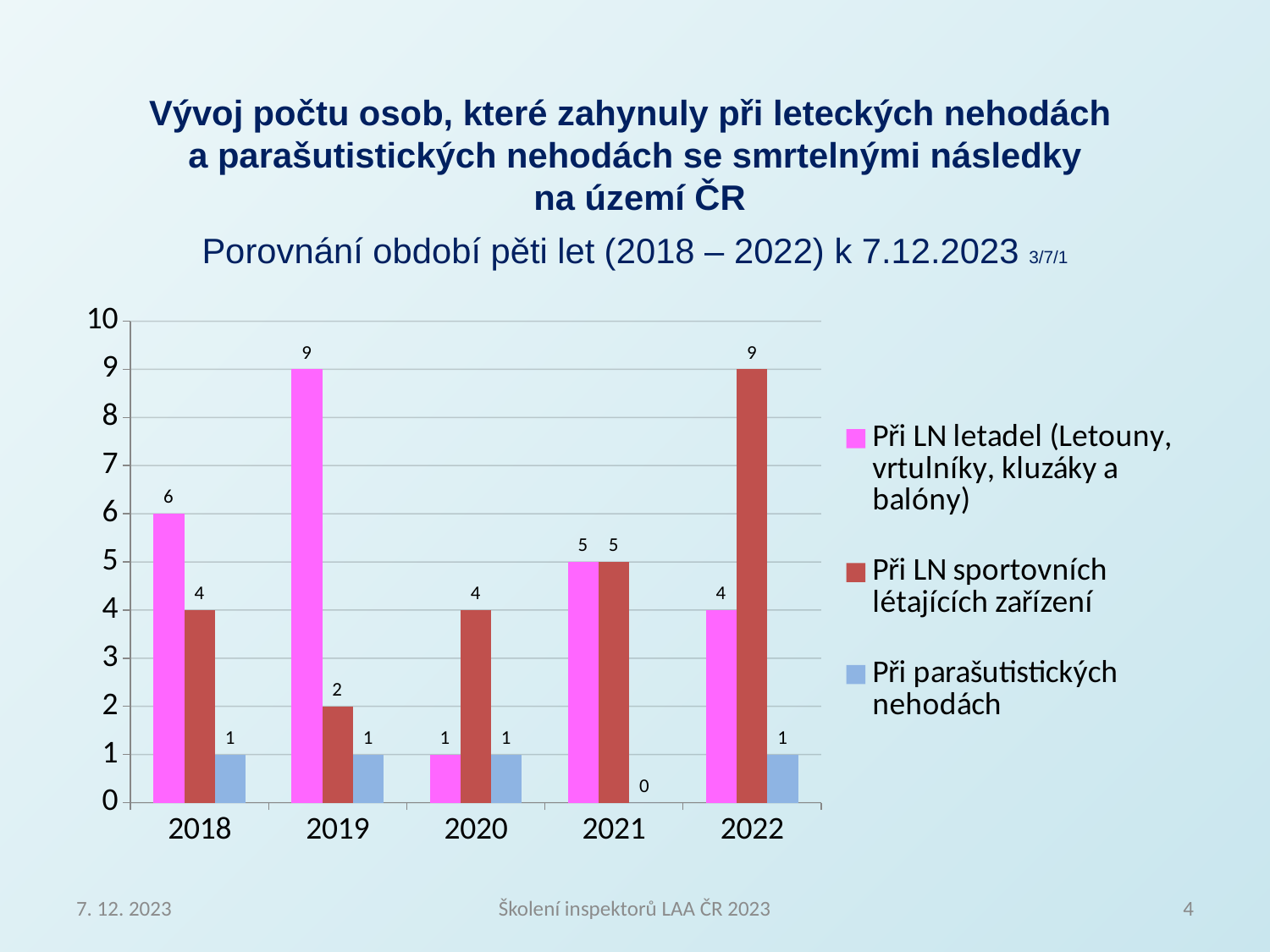
What is the value for 'Při parašutistických nehodách' in 2021? 0 What is the value for 'Při LN sportovních létajících zařízení' in 2019? 2 Does the value for 'Při LN sportovních létajících zařízení' rise or fall from 2020 to 2022? Rise In which year is the value for 'Při LN letadel (Letouny, vrtulníky, kluzáky a balóny)' the lowest? 2020 How many years are shown on the x axis? 5 How many series does the legend list? 3 What kind of chart is shown on the slide? Bar chart Which is larger in 2022: the value for 'Při LN letadel' or the value for 'Při LN sportovních létajících zařízení'? Při LN sportovních létajících zařízení What is the difference between the 'Při LN letadel' value in 2018 and the 'Při LN sportovních létajících zařízení' value in 2018? 2 What is the value for 'Při LN sportovních létajících zařízení' in 2022? 9 What is the value for 'Při LN letadel (Letouny, vrtulníky, kluzáky a balóny)' in 2019? 9 In which year is the value for 'Při LN letadel (Letouny, vrtulníky, kluzáky a balóny)' the highest? 2019